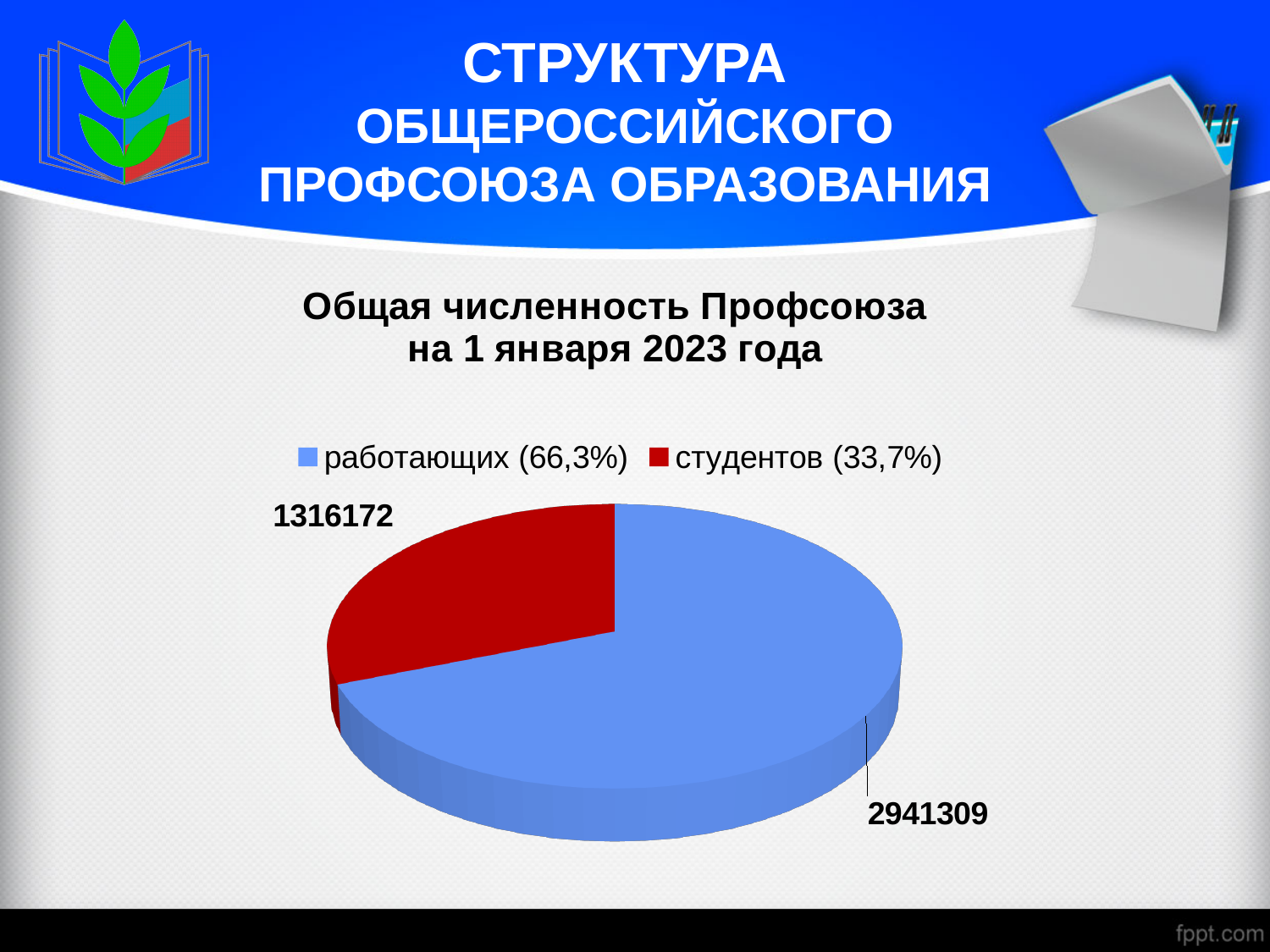
What share of the pie does студентов represent, according to the legend? 33,7% What is the value for работающих? 2941309 What is the total of the two values shown in the pie chart? 4257481 How many slices does the pie chart have? 2 Which is larger, the value for работающих or the value for студентов? работающих What is the title of the chart? Общая численность Профсоюза на 1 января 2023 года What kind of chart is shown on the slide? pie chart What share of the pie does работающих represent, according to the legend? 66,3% Which category has the largest slice of the pie? работающих Which category has the smallest slice of the pie? студентов What is the difference between the value for работающих and the value for студентов? 1625137 What is the value for студентов? 1316172